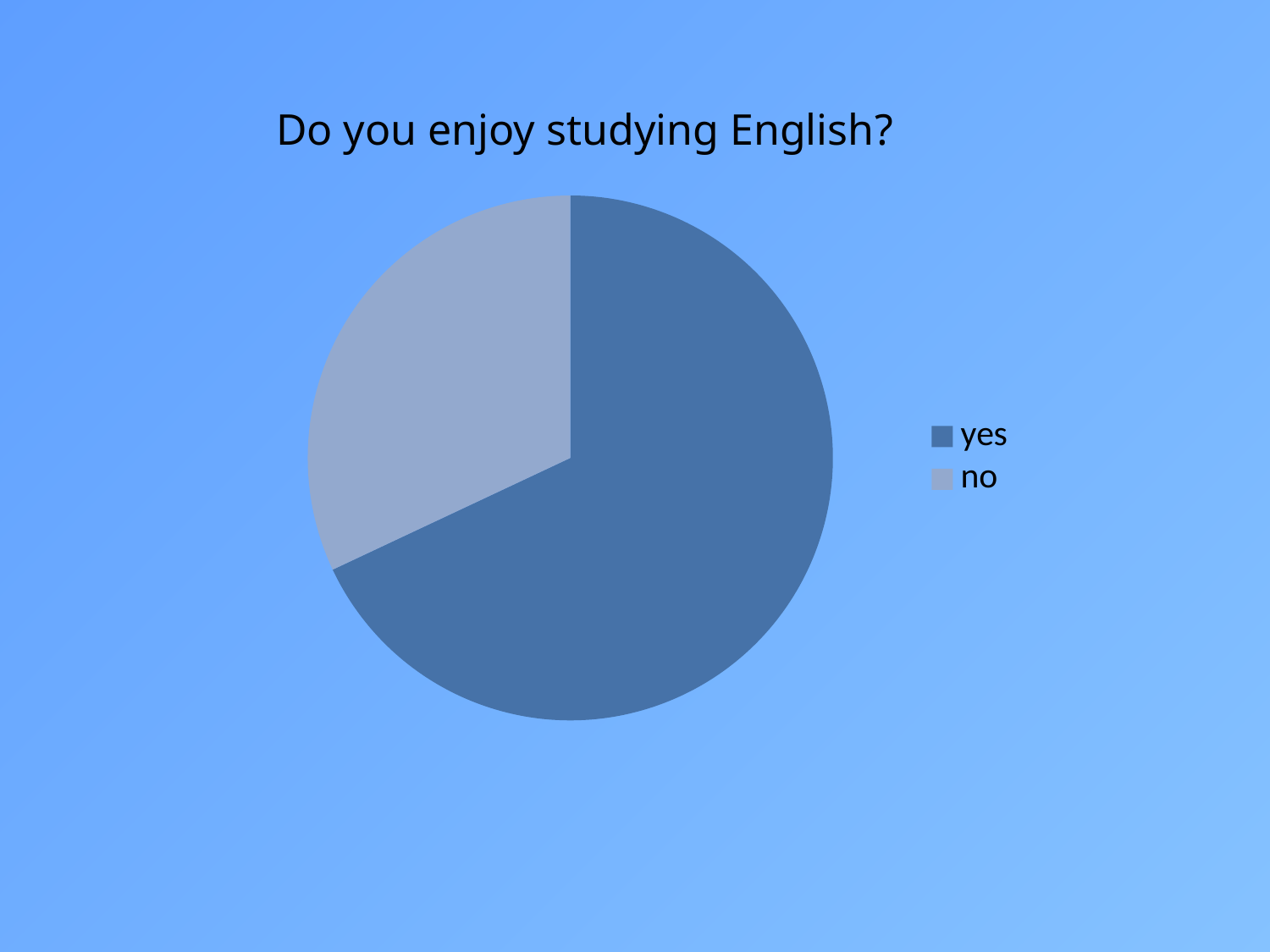
What is the title of the chart? Do you enjoy studying English? What kind of chart is shown on the slide? pie chart How many slices does the pie chart have? 2 Which slice is the largest? yes Which is larger, the "yes" slice or the "no" slice? yes Which legend entry is shown in the darker blue colour? yes How many entries does the legend list? 2 Which slice is the smallest? no